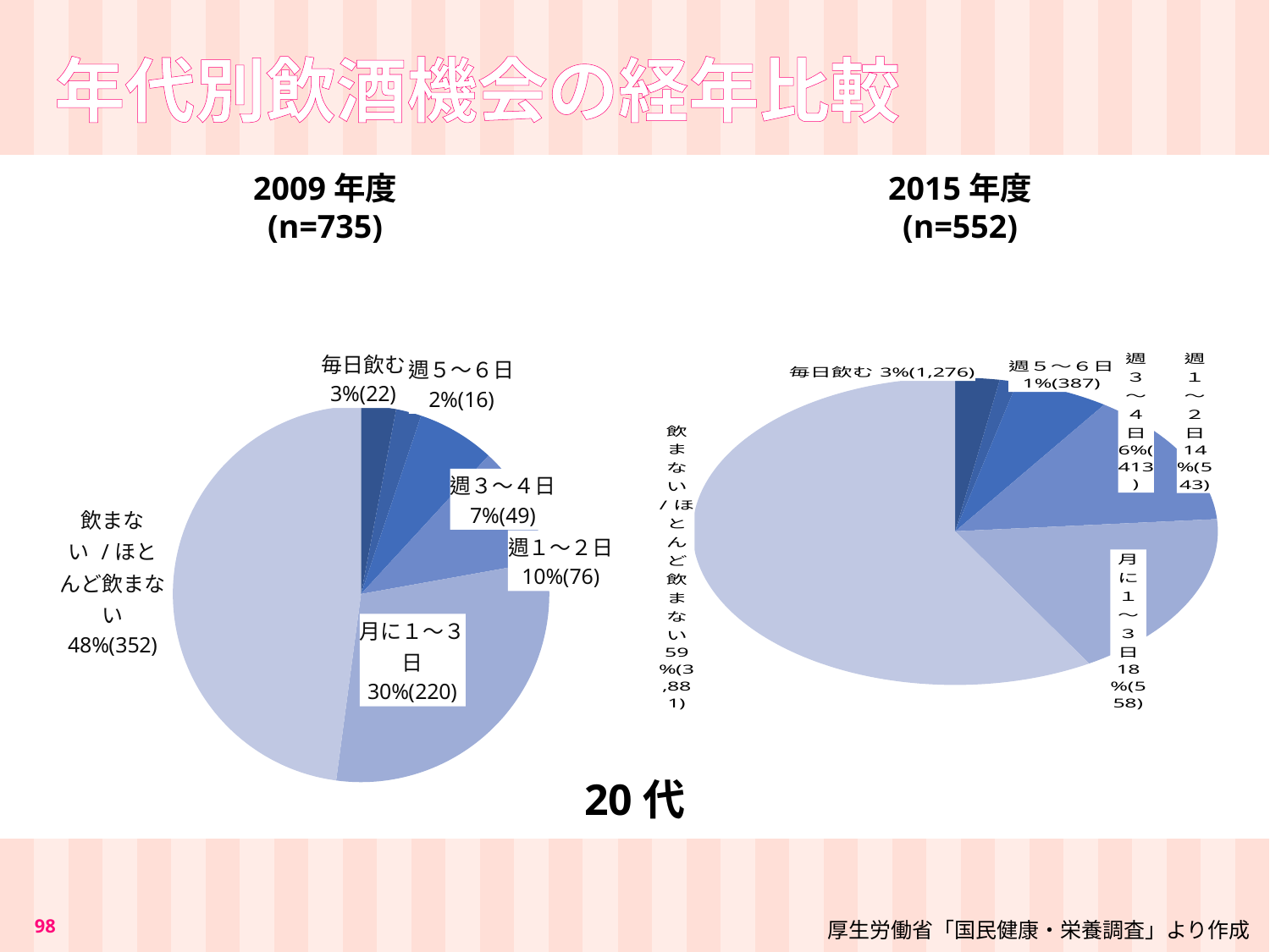
In the 2009年度 pie chart, what is the value for 週3～4日? 7%(49) In the 2009年度 pie chart, which category has the smallest share? 週5～6日 How many categories does the 2009年度 pie chart show? 6 In the 2015年度 pie chart, which category has the smallest share? 週5～6日 What is the sample size (n) shown for the 2015年度 chart? 552 What kind of chart is used for the 2015年度 data? Pie chart In the 2015年度 pie chart, which is larger, the share for 週1～2日 or the share for 週3～4日? 週1～2日 In the 2009年度 pie chart, what is the value for 月に1～3日? 30%(220) In the 2015年度 pie chart, what is the value for 飲まない/ほとんど飲まない? 59%(3,881) In the 2015年度 pie chart, what is the value for 週1～2日? 14%(543) In the 2009年度 pie chart, which category has the largest share? 飲まない/ほとんど飲まない In the 2009年度 pie chart, what is the difference in percentage points between 飲まない/ほとんど飲まない and 月に1～3日? 18